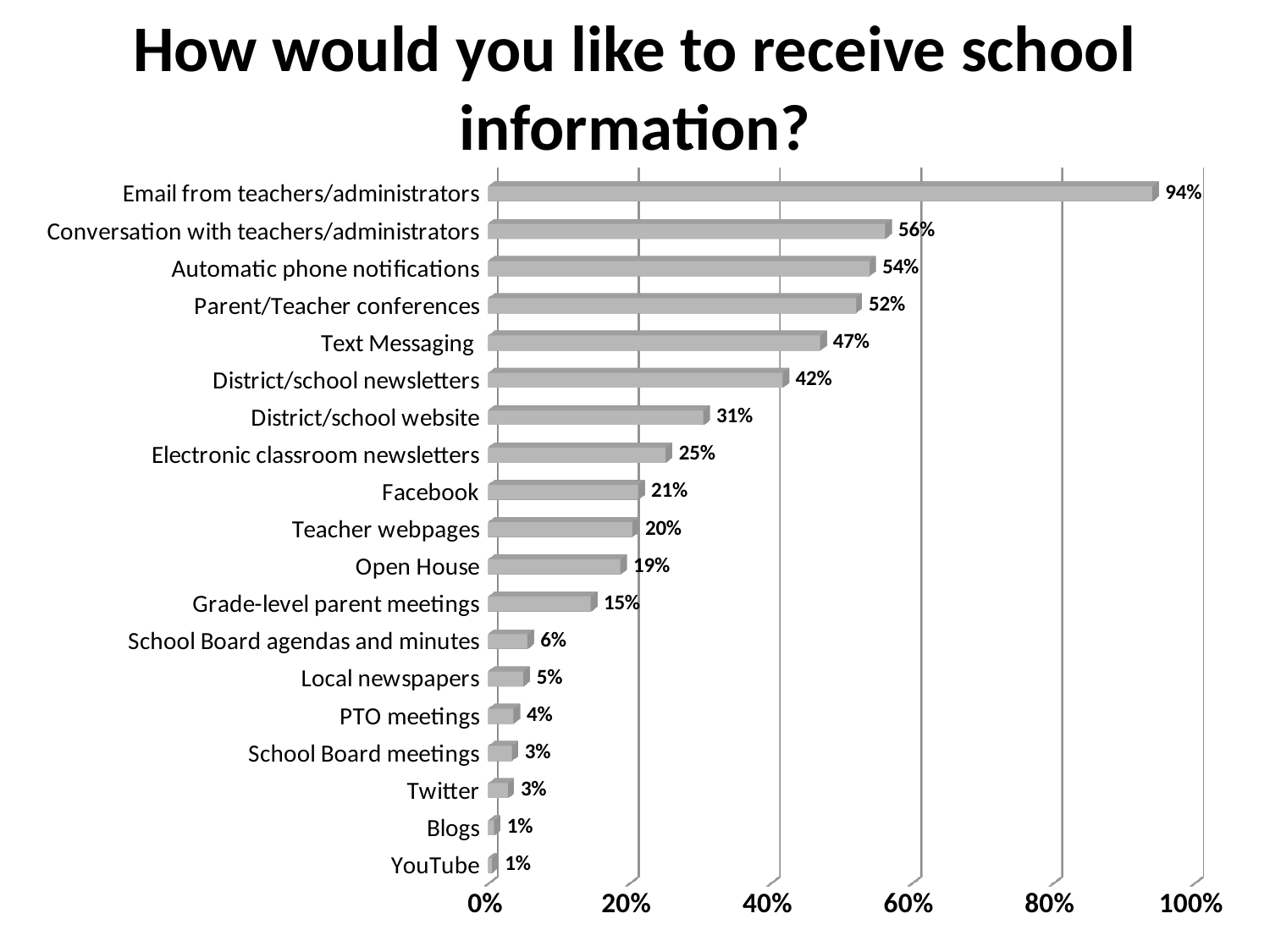
What is the difference between District/school newsletters and District/school website? 11% What is the difference between Email from teachers/administrators and Conversation with teachers/administrators? 38% What is the value for Text Messaging? 47% What is the value for Twitter? 3% How many categories are shown in the chart? 19 Which category has the highest value? Email from teachers/administrators What kind of chart is shown on the slide? Bar chart What percentage of respondents chose Email from teachers/administrators? 94% Which is larger, Facebook or Open House? Facebook Which is larger, Automatic phone notifications or Parent/Teacher conferences? Automatic phone notifications What is the title of the chart? How would you like to receive school information? What is the value for Grade-level parent meetings? 15%